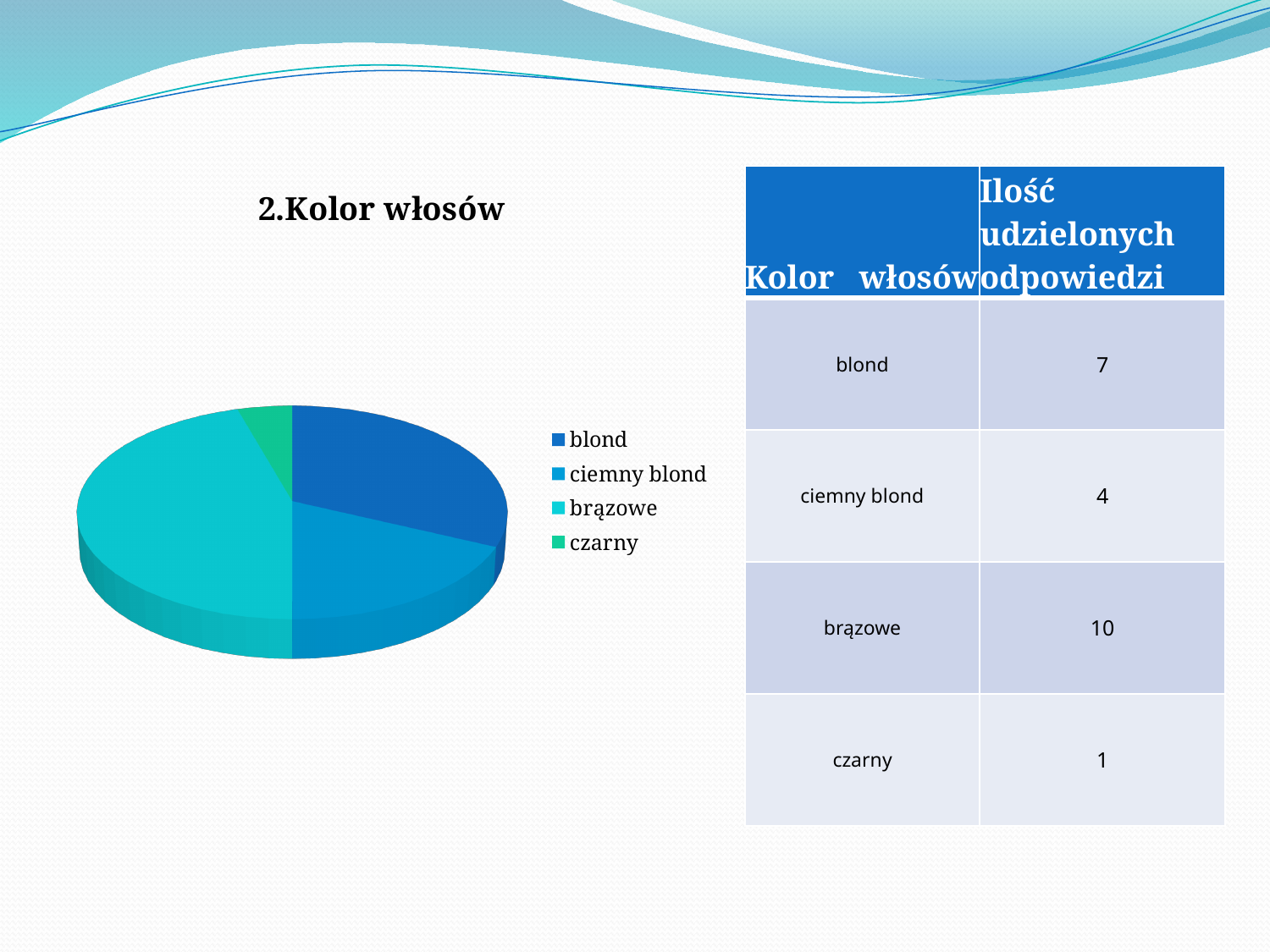
What kind of chart is shown on the slide? pie chart What is the title of the chart on the slide? 2.Kolor włosów How many categories does the pie chart's legend list? 4 Which hair colour has the smallest slice in the pie chart? czarny According to the slide, how many responses were given for ciemny blond? 4 According to the slide, how many responses were given for blond? 7 Which slice is larger in the pie chart, blond or ciemny blond? blond According to the slide, how many responses were given for czarny? 1 Which hair colour has the largest slice in the pie chart? brązowe According to the slide, how many responses were given for brązowe? 10 What is the difference between the number of responses for brązowe and for blond? 3 What is the total number of responses across all four hair colours shown on the slide? 22